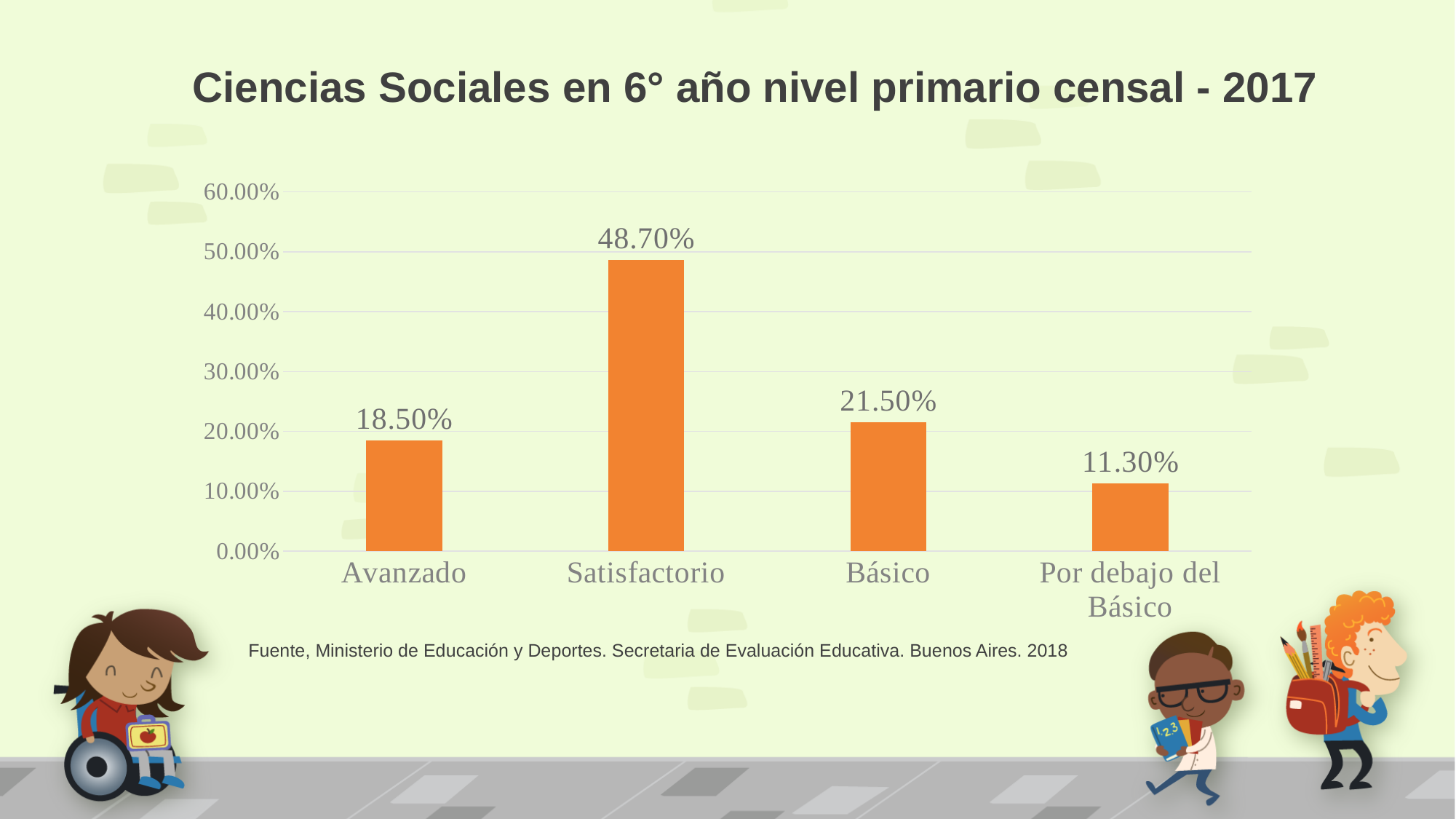
Is the value for Avanzado greater or less than 20.00%? less What is the value for Avanzado? 18.50% What is the title of the chart? Ciencias Sociales en 6° año nivel primario censal - 2017 What is the value for Básico? 21.50% What is the value for Por debajo del Básico? 11.30% Which category has the lowest value? Por debajo del Básico How many categories are shown on the x axis? 4 What is the difference between the values for Satisfactorio and Básico? 27.20% Which category has the highest value? Satisfactorio What kind of chart is shown on the slide? bar chart What is the value for Satisfactorio? 48.70% Which is larger, the value for Básico or the value for Avanzado? Básico